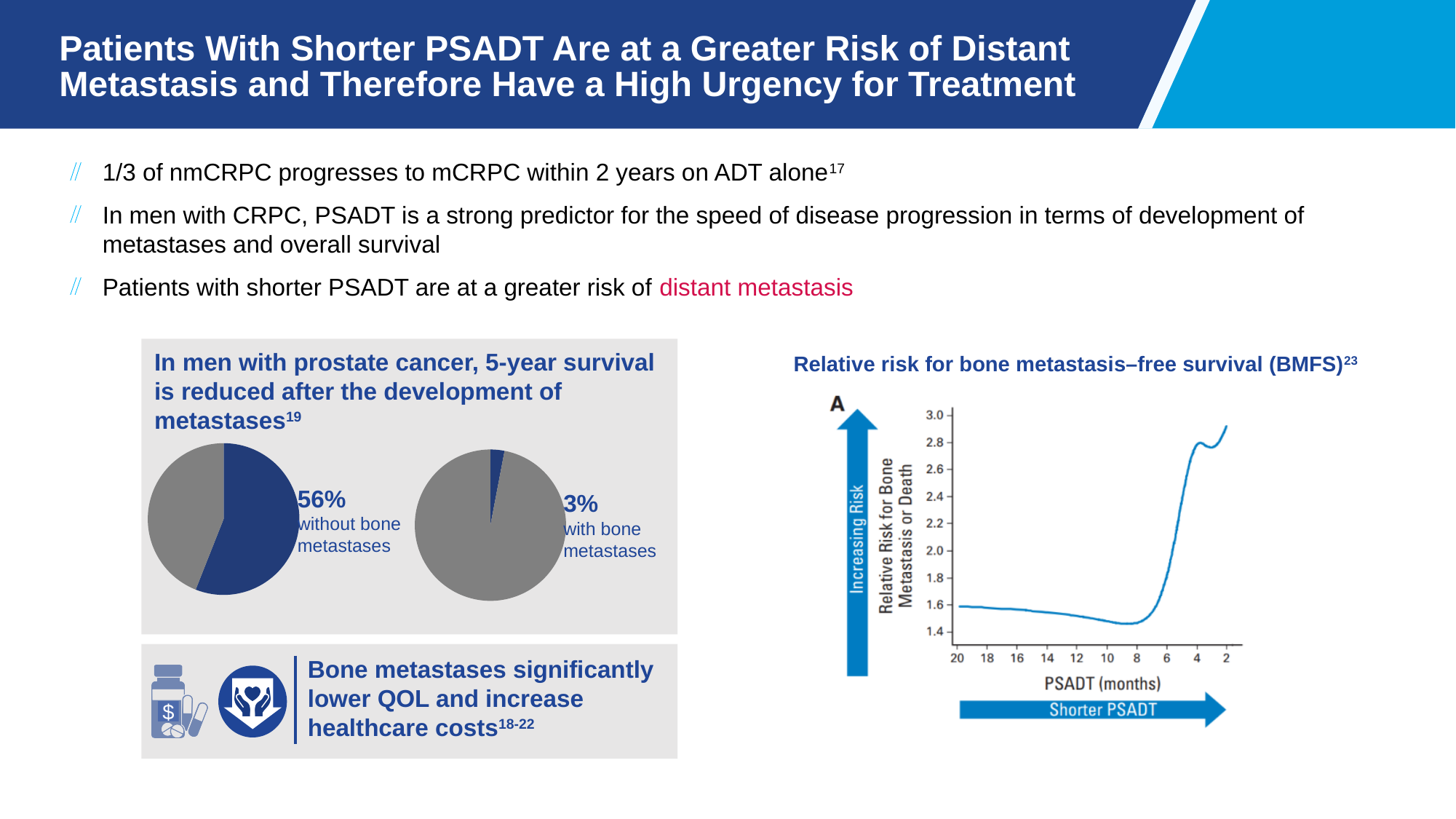
In the right pie chart, what is the 5-year survival percentage for men with bone metastases? 3% In the 'Relative risk for bone metastasis–free survival (BMFS)' chart, is the relative risk at a PSADT of 20 months greater or less than 2.0? less In the 'Relative risk for bone metastasis–free survival (BMFS)' chart, does the relative risk rise or fall as PSADT gets shorter (moving from 20 months to 2 months along the x axis)? Rise In the left pie chart, what is the 5-year survival percentage for men without bone metastases? 56% How many tick labels are shown on the x axis of the 'Relative risk for bone metastasis–free survival (BMFS)' chart? 10 In the 'Relative risk for bone metastasis–free survival (BMFS)' chart, is the relative risk at a PSADT of 10 months greater or less than 1.8? less What is the x-axis label of the 'Relative risk for bone metastasis–free survival (BMFS)' chart? PSADT (months) What kind of charts are used to show 5-year survival with and without bone metastases? Pie charts According to the pie charts, which group has the higher 5-year survival: men with bone metastases or men without bone metastases? Without bone metastases What is the difference in 5-year survival between men without bone metastases and men with bone metastases, according to the pie charts? 53 percentage points What kind of chart is the 'Relative risk for bone metastasis–free survival (BMFS)' chart? Line chart In the 'Relative risk for bone metastasis–free survival (BMFS)' chart, is the relative risk at a PSADT of 2 months greater or less than 2.6? greater